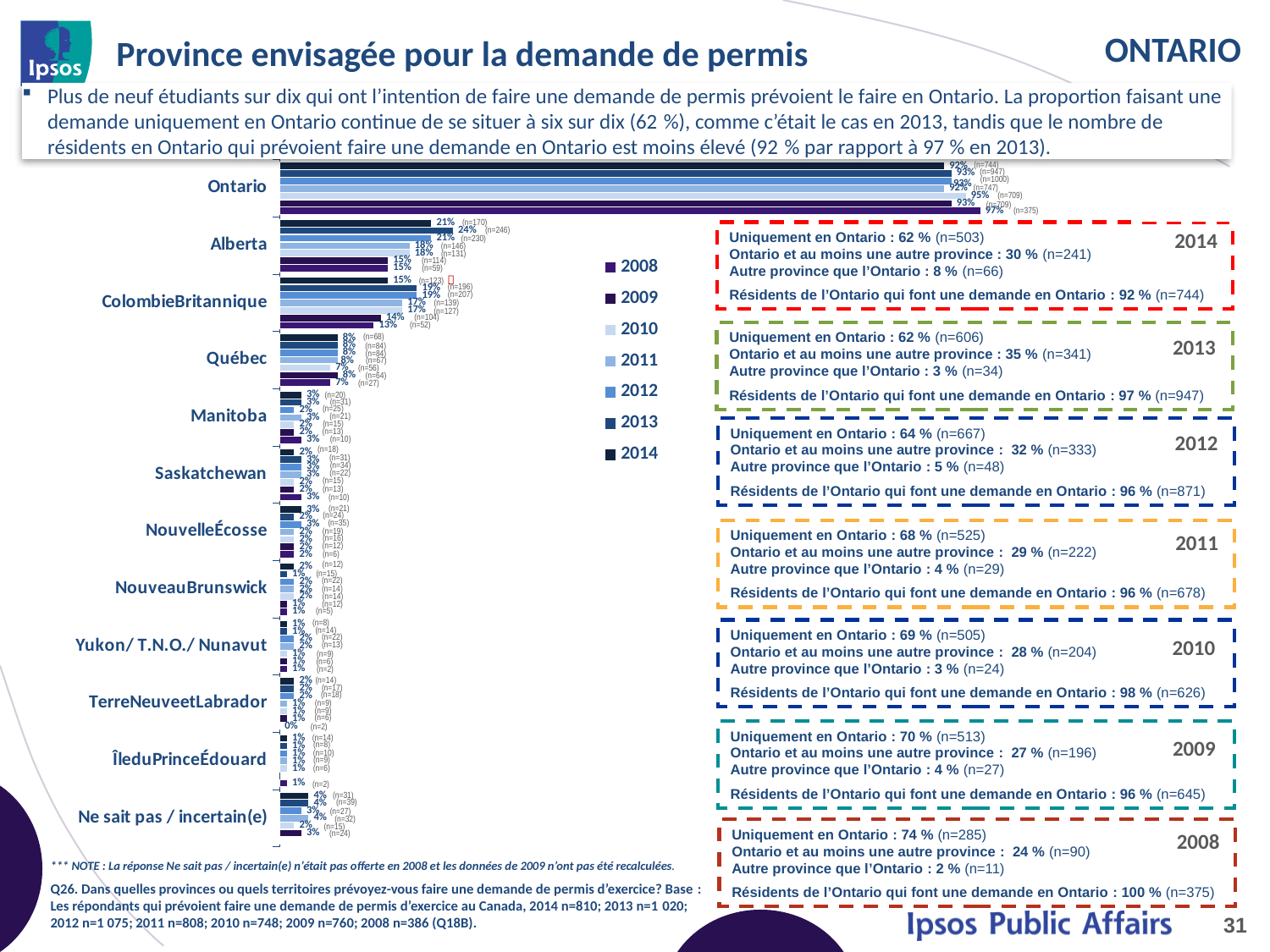
What kind of chart is shown on the slide? bar chart What is the title of the chart on the slide? Province envisagée pour la demande de permis What is the 2014 value for Colombie-Britannique in the chart? 15% Which has the larger 2014 value, Alberta or Québec? Alberta Which category has the highest values across all years in the chart? Ontario What is the 2008 value for Ontario in the chart? 97% What is the 2013 value for Alberta in the chart? 24% By how many percentage points does Alberta's 2013 value exceed its 2014 value? 3 percentage points What is the 2014 value for Alberta in the chart? 21% How many series does the chart legend list? 7 What is the 2014 value for Ontario in the chart? 92% How many categories (provinces/territories plus 'Ne sait pas / incertain(e)') are shown on the chart's vertical axis? 12